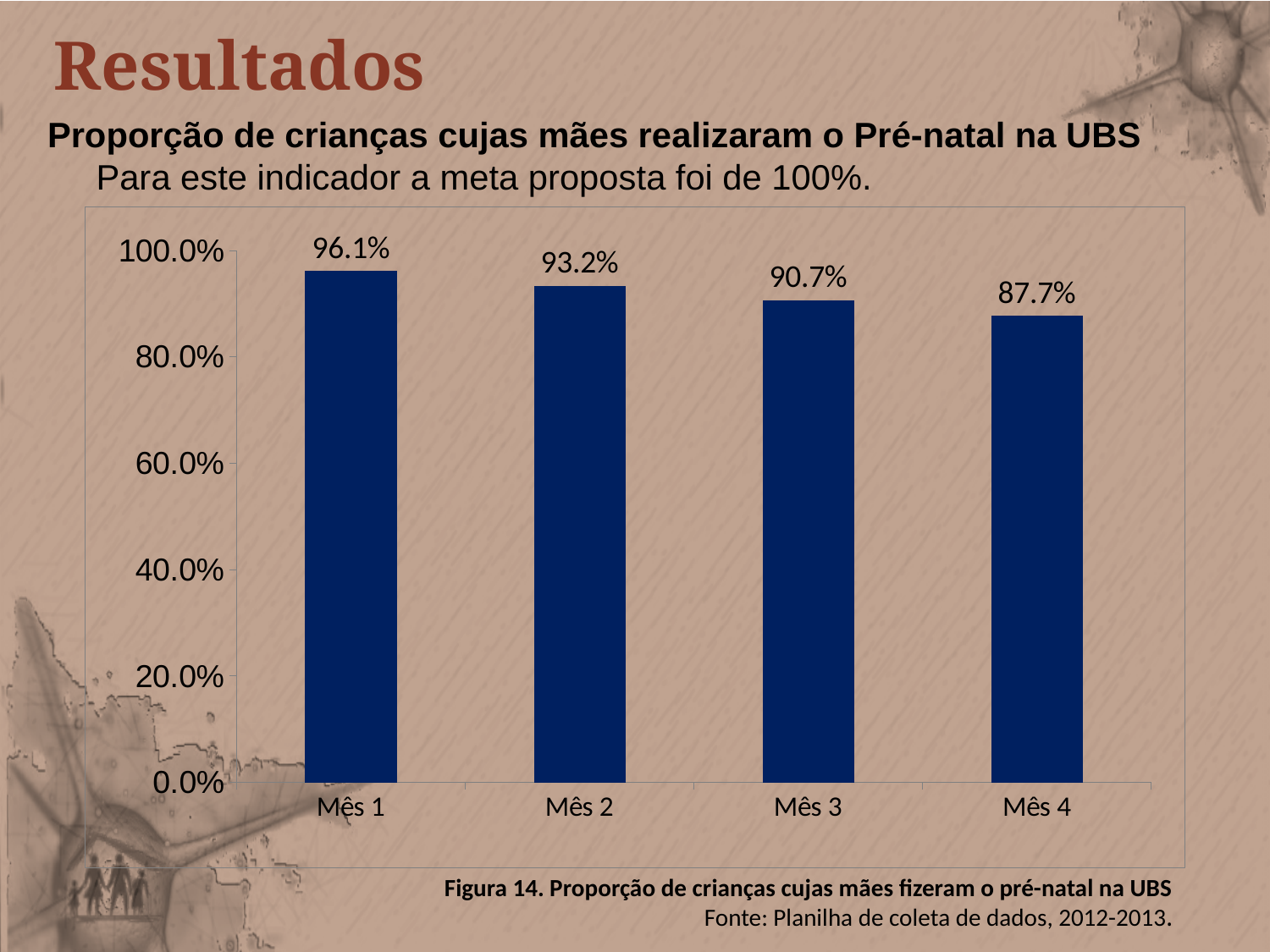
What is the difference between the values for Mês 2 and Mês 3? 2.5% Is the value for Mês 4 greater or less than 80.0%? greater Which month has the highest value? Mês 1 How many months are shown on the x axis? 4 What is the value for Mês 1? 96.1% What is the value for Mês 3? 90.7% Which is larger, the value for Mês 2 or the value for Mês 3? Mês 2 Which month has the lowest value? Mês 4 What is the difference between the values for Mês 1 and Mês 4? 8.4% What kind of chart is shown on the slide? bar chart What is the value for Mês 4? 87.7% Do the values rise or fall from Mês 1 to Mês 4? fall